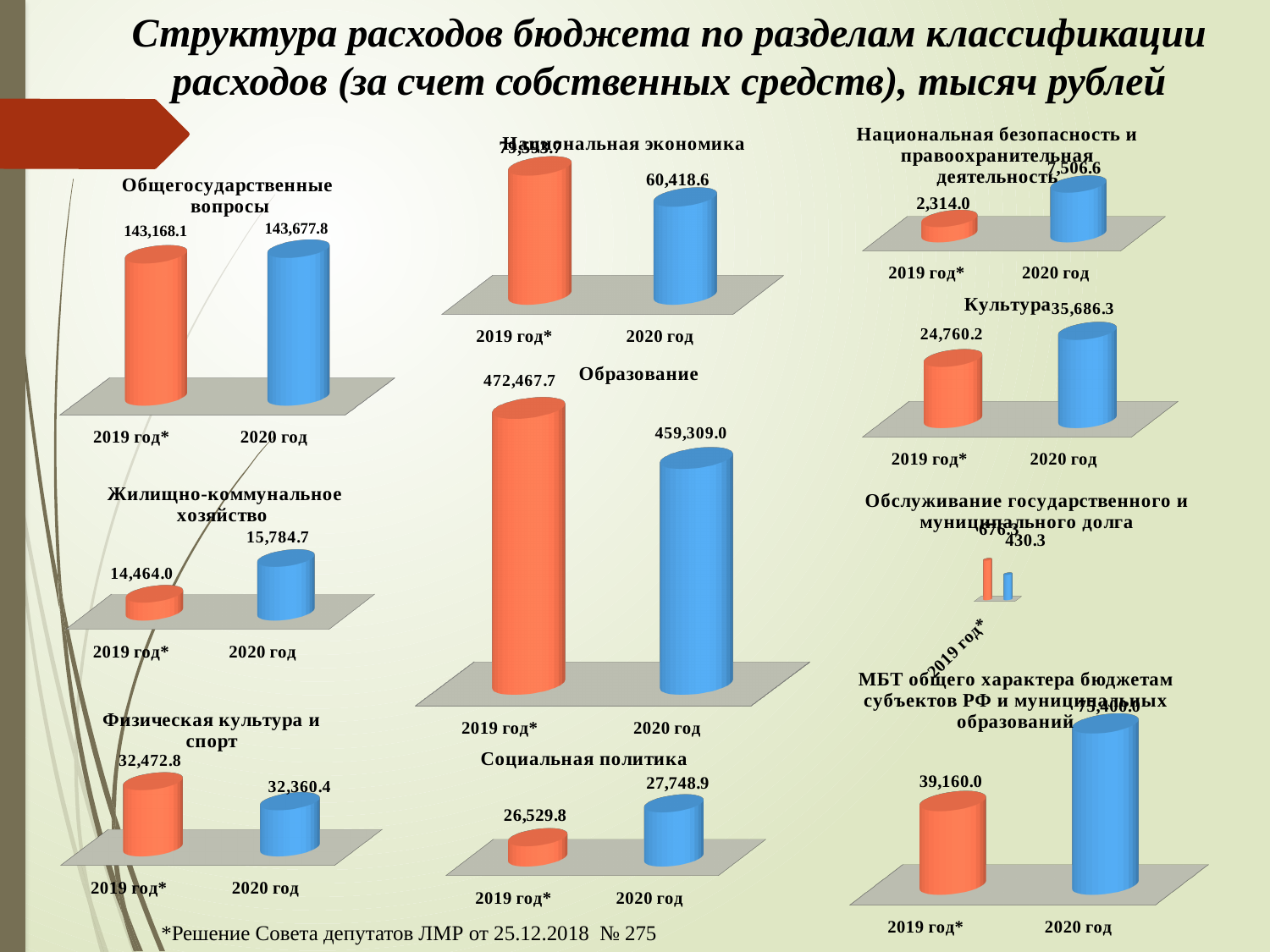
In the 'Социальная политика' chart, what is the value for 2019 год*? 26,529.8 In the 'Образование' chart, what is the value for 2019 год*? 472,467.7 How many categories (years) are shown in the 'Образование' chart? 2 In the 'Национальная безопасность и правоохранительная деятельность' chart, which year has the lower value? 2019 год* In the 'Культура' chart, what is the difference between the 2020 год and 2019 год* values? 10,926.1 In the 'Образование' chart, which year has the higher value, 2019 год* or 2020 год? 2019 год* What kind of chart is used for 'Социальная политика'? bar chart In the 'Общегосударственные вопросы' chart, what is the value for 2020 год? 143,677.8 In the 'Физическая культура и спорт' chart, do the values rise or fall from 2019 год* to 2020 год? fall In the 'Жилищно-коммунальное хозяйство' chart, what is the difference between the 2020 год and 2019 год* values? 1,320.7 In the 'Культура' chart, what is the value for 2020 год? 35,686.3 In the 'Национальная безопасность и правоохранительная деятельность' chart, what is the value for 2019 год*? 2,314.0